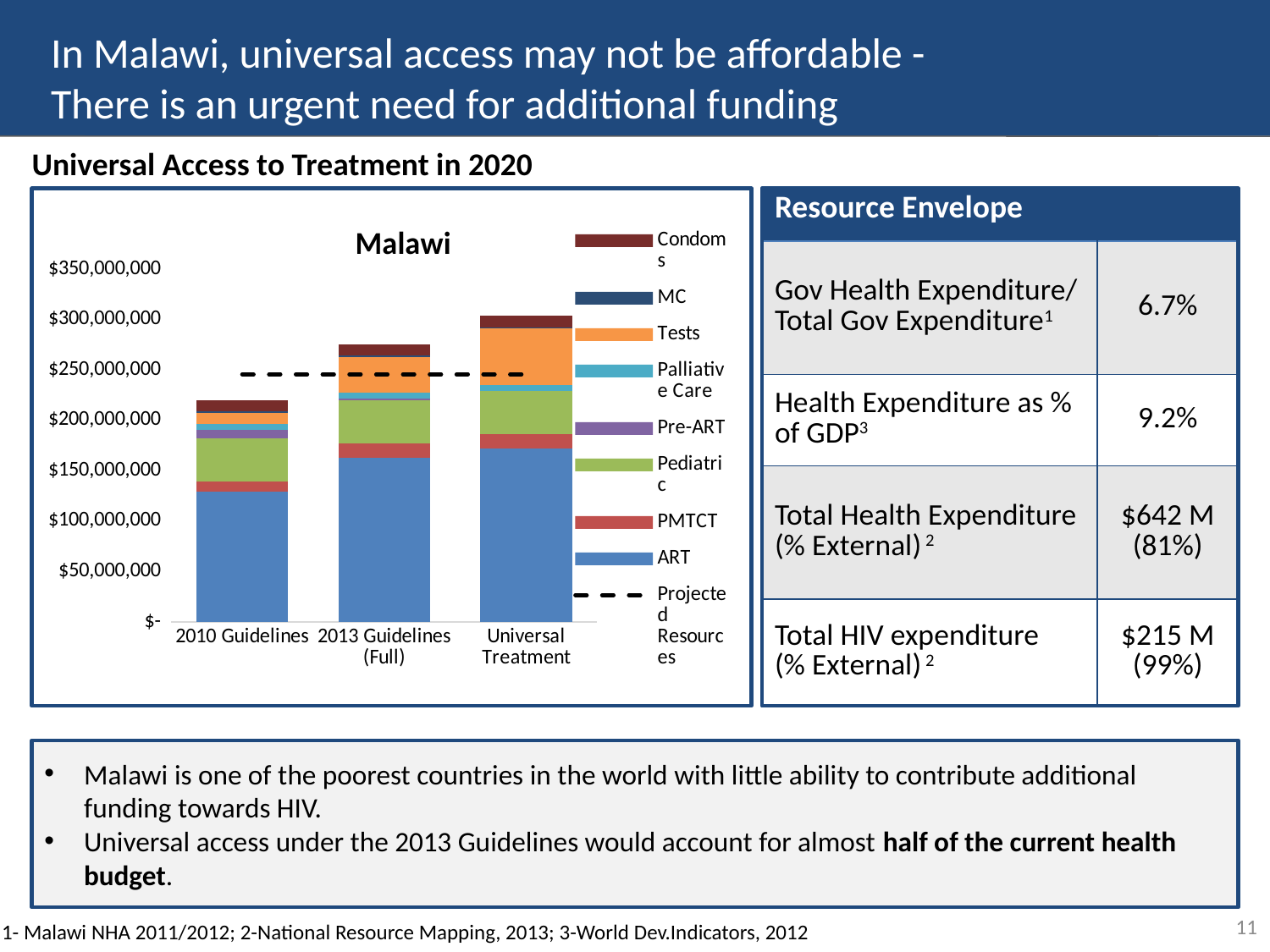
How many categories are shown on the x axis of the chart? 3 How many entries does the chart's legend list? 9 Is the ART segment for 2010 Guidelines greater or less than $150,000,000? less Which legend entry is drawn as a dashed line rather than a bar segment? Projected Resources Is the total bar for 2010 Guidelines greater or less than $200,000,000? greater Which category has the lowest total bar? 2010 Guidelines Which category has the highest total bar? Universal Treatment Do the total bar heights rise or fall from 2010 Guidelines to Universal Treatment? Rise What is the title of the chart? Malawi Is the total bar for 2013 Guidelines (Full) greater or less than $250,000,000? greater What kind of chart is shown on the slide? Stacked bar chart